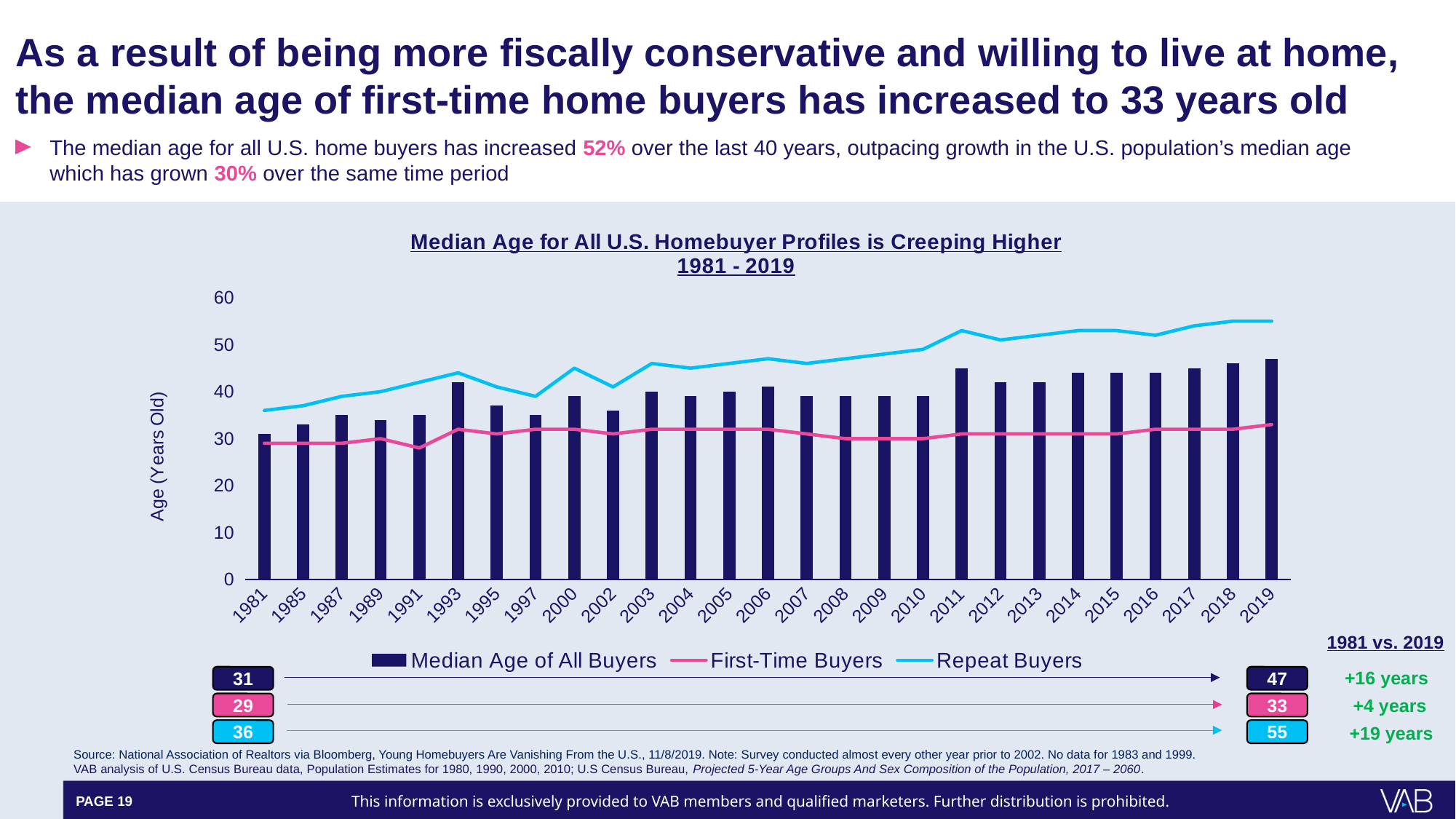
What is the difference between the median age of repeat buyers and first-time buyers in 2019? 22 Is the median age of repeat buyers in 2011 greater or less than 50? greater Which series has the highest median age in 2019? Repeat Buyers By how many years did the median age of repeat buyers increase from 1981 to 2019? +19 years What is the median age of all buyers in 1981? 31 How many series does the legend list? 3 What is the median age of first-time buyers in 2019? 33 In which year is the Median Age of All Buyers bar the lowest? 1981 Does the median age of repeat buyers generally rise or fall from 1981 to 2019? Rise Which is larger: the median age of repeat buyers in 1981 or the median age of first-time buyers in 1981? Repeat buyers in 1981 What kind of chart is shown on the slide? Combination bar and line chart What is the median age of repeat buyers in 2019? 55